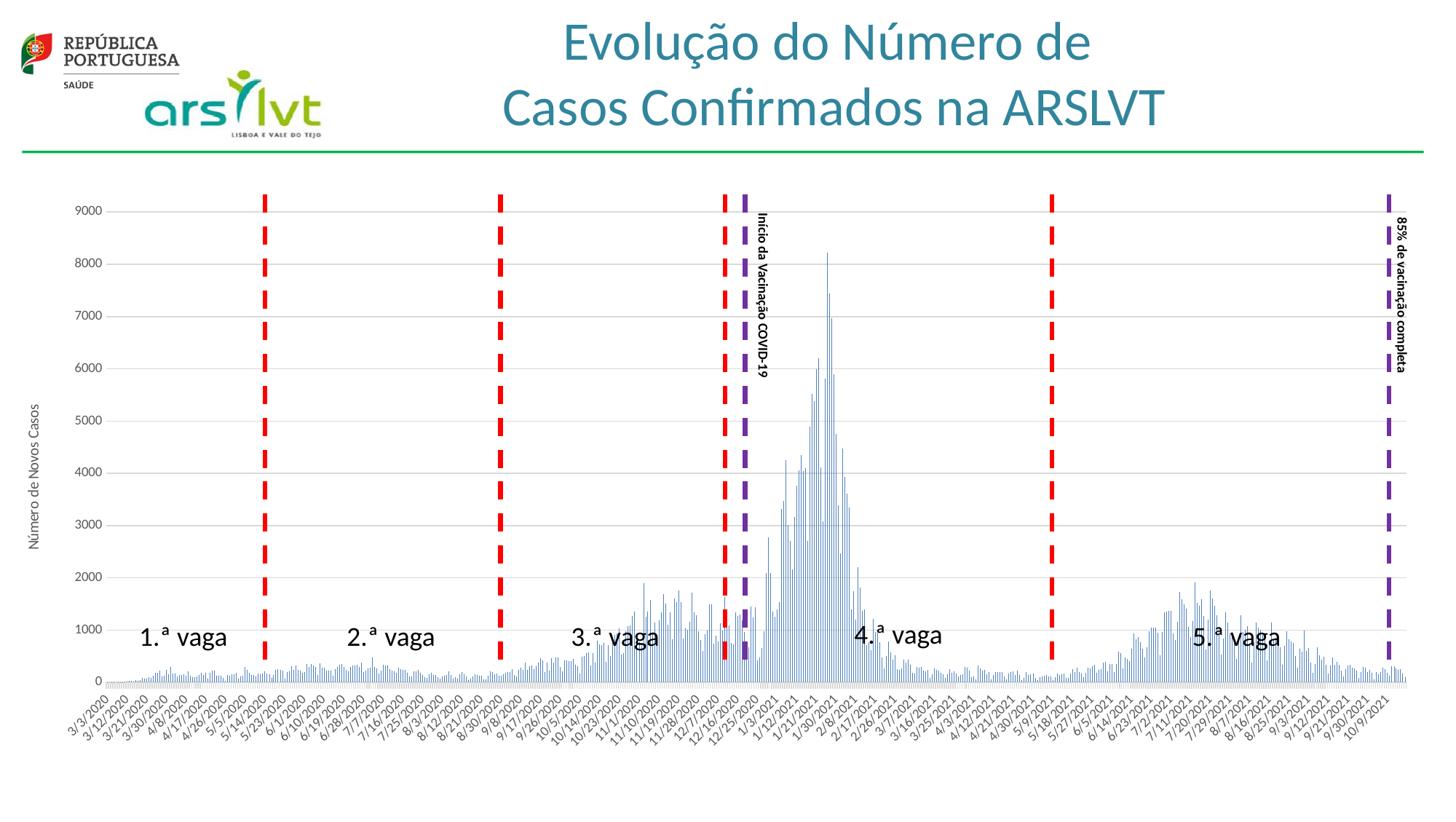
Which has a higher peak of new cases, the 4.ª vaga or the 5.ª vaga? 4.ª vaga How many waves (vagas) are labelled on the chart? 5 Is the peak value of the 4.ª vaga greater or less than 7000? greater Do the daily new cases rise or fall between the peak of the 4.ª vaga and 5/9/2021? fall Which has a higher peak of new cases, the 3.ª vaga or the 2.ª vaga? 3.ª vaga What kind of chart is shown on the slide? bar chart Which labelled wave has the highest peak of new cases? 4.ª vaga What event does the purple dashed line near 12/25/2020 mark? Início da Vacinação COVID-19 What is the highest value shown on the y axis? 9000 Is the peak value of the 1.ª vaga greater or less than 1000? less What is the title of the chart on the slide? Evolução do Número de Casos Confirmados na ARSLVT